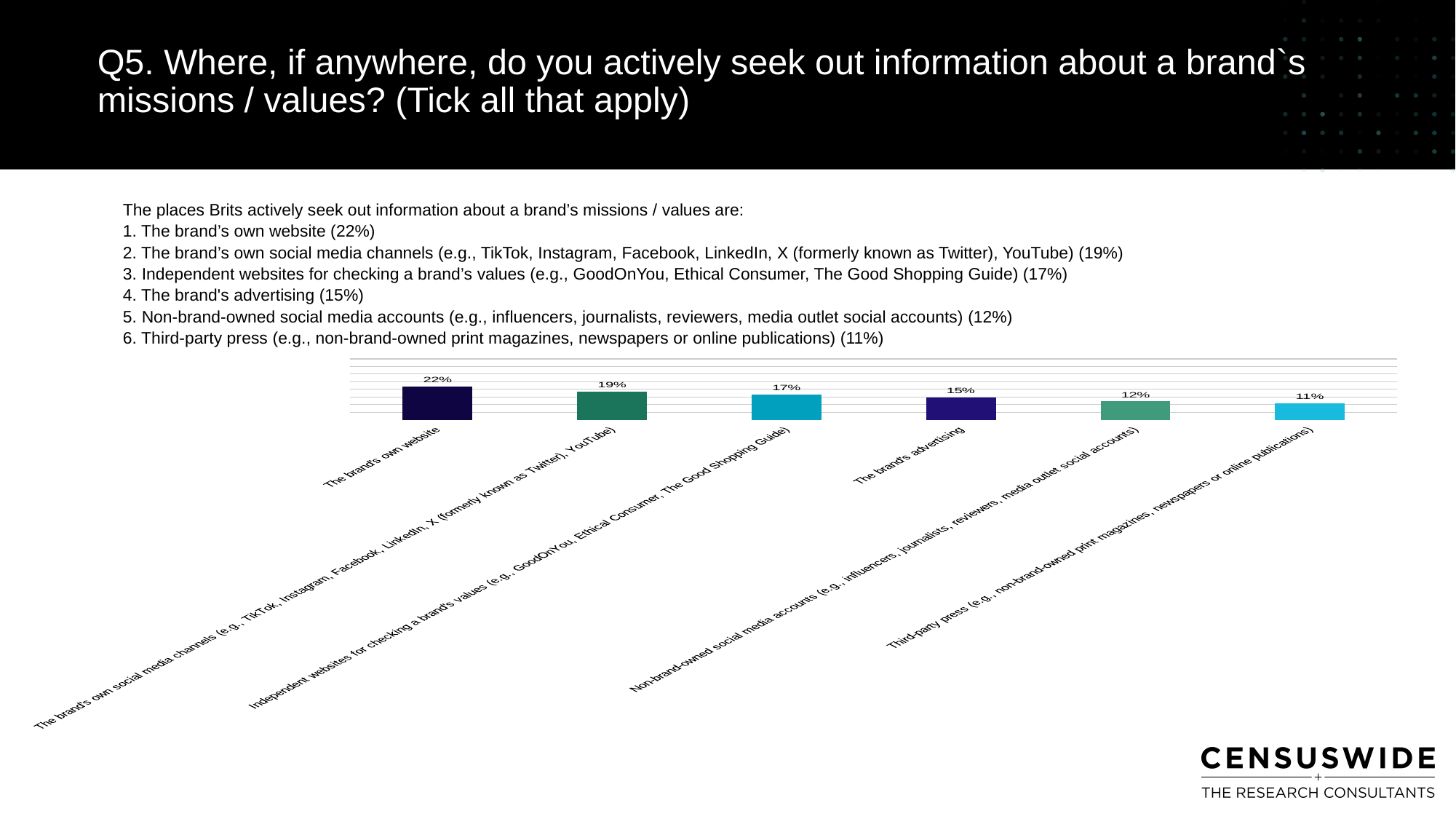
How many categories are plotted in the chart? 6 Do the values rise or fall from left to right along the x axis? Fall What is the difference between the brand's own social media channels and independent websites for checking a brand's values? 2% Which category has the lowest value in the chart? Third-party press What is the difference between the value for the brand's own website and the value for third-party press? 11% Which category has the highest value in the chart? The brand's own website What kind of chart is shown on the slide? Bar chart What value is shown for the brand's advertising? 15% What percentage of respondents seek out information about a brand's missions / values on the brand's own website? 22% Which is larger: the value for the brand's advertising or the value for non-brand-owned social media accounts? The brand's advertising What value is shown for non-brand-owned social media accounts? 12% What percentage is shown for third-party press? 11%